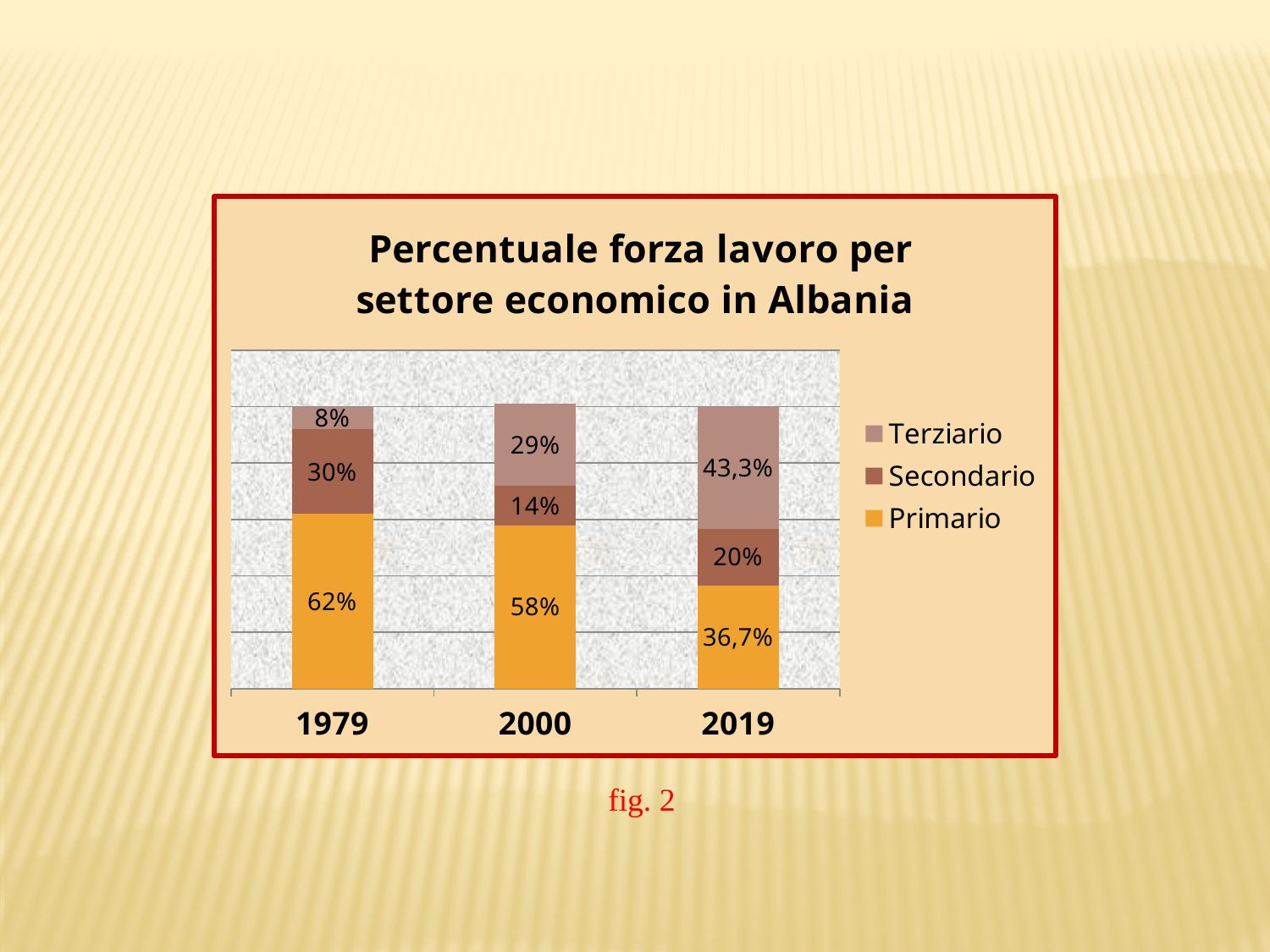
How many years are shown on the x axis? 3 What is the Primario value for 2019? 36,7% What is the difference between the Secondario values for 1979 and 2000? 16% What kind of chart is shown? Stacked bar chart What is the Terziario value for 2019? 43,3% What is the Primario value for 1979? 62% In which year is the Terziario value highest? 2019 How many series does the legend list? 3 Does the Primario value rise or fall from 1979 to 2019? Fall Which is larger, the Terziario value for 2000 or the Secondario value for 2000? Terziario In which year is the Primario value lowest? 2019 What is the Secondario value for 2000? 14%